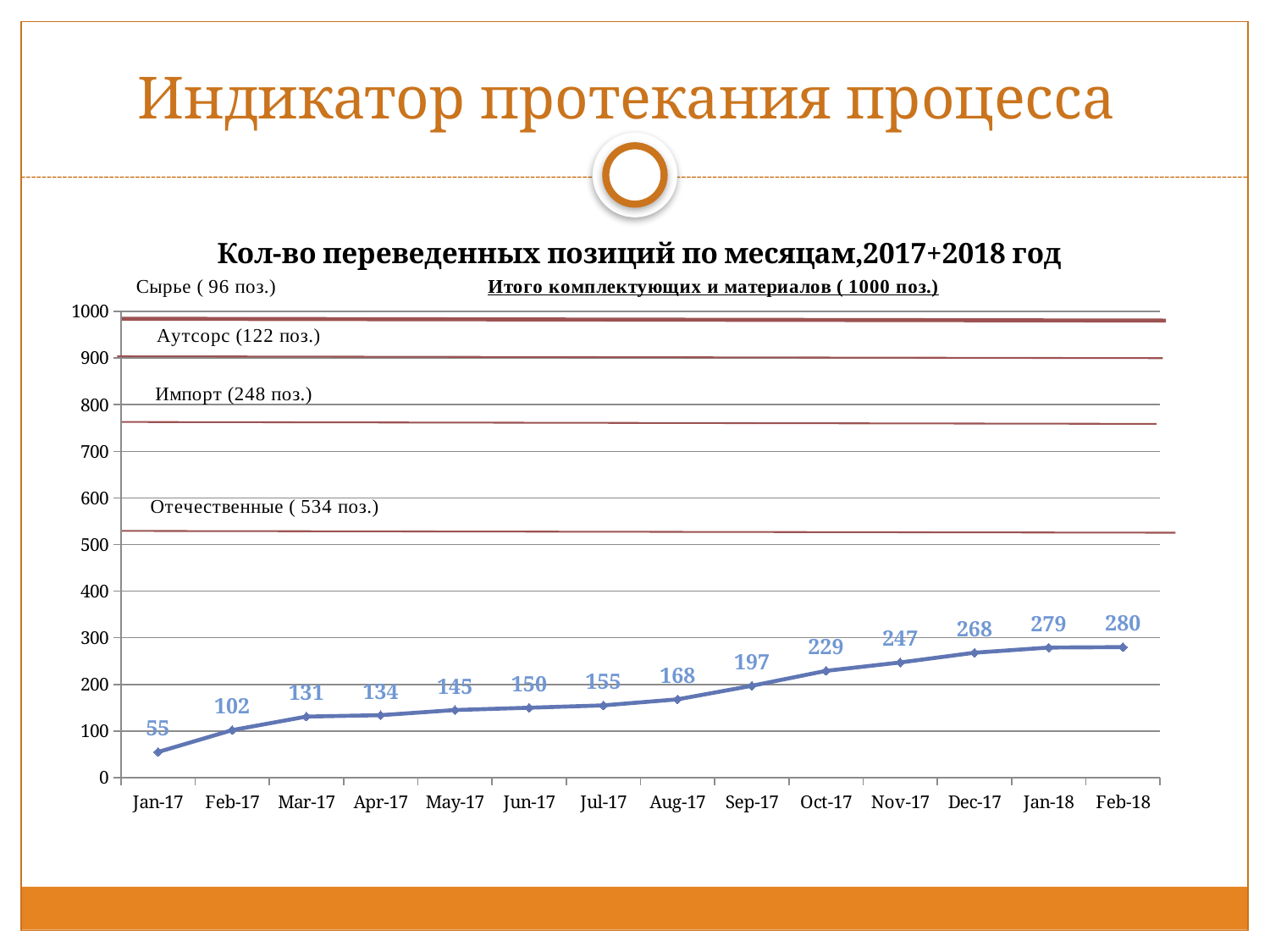
How many months are plotted on the x axis? 14 What is the difference between the values for Feb-18 and Jan-17? 225 Which is larger, the value for Oct-17 or the value for Jul-17? Oct-17 Which month has the lowest value? Jan-17 What is the difference between the values for Sep-17 and Aug-17? 29 What is the value for Sep-17? 197 Do the values rise or fall from Jan-17 to Feb-18? rise What is the value for Jan-17? 55 What kind of chart is shown? line chart Which month has the highest value? Feb-18 What is the value for Dec-17? 268 Is the value for Nov-17 greater or less than 200? greater